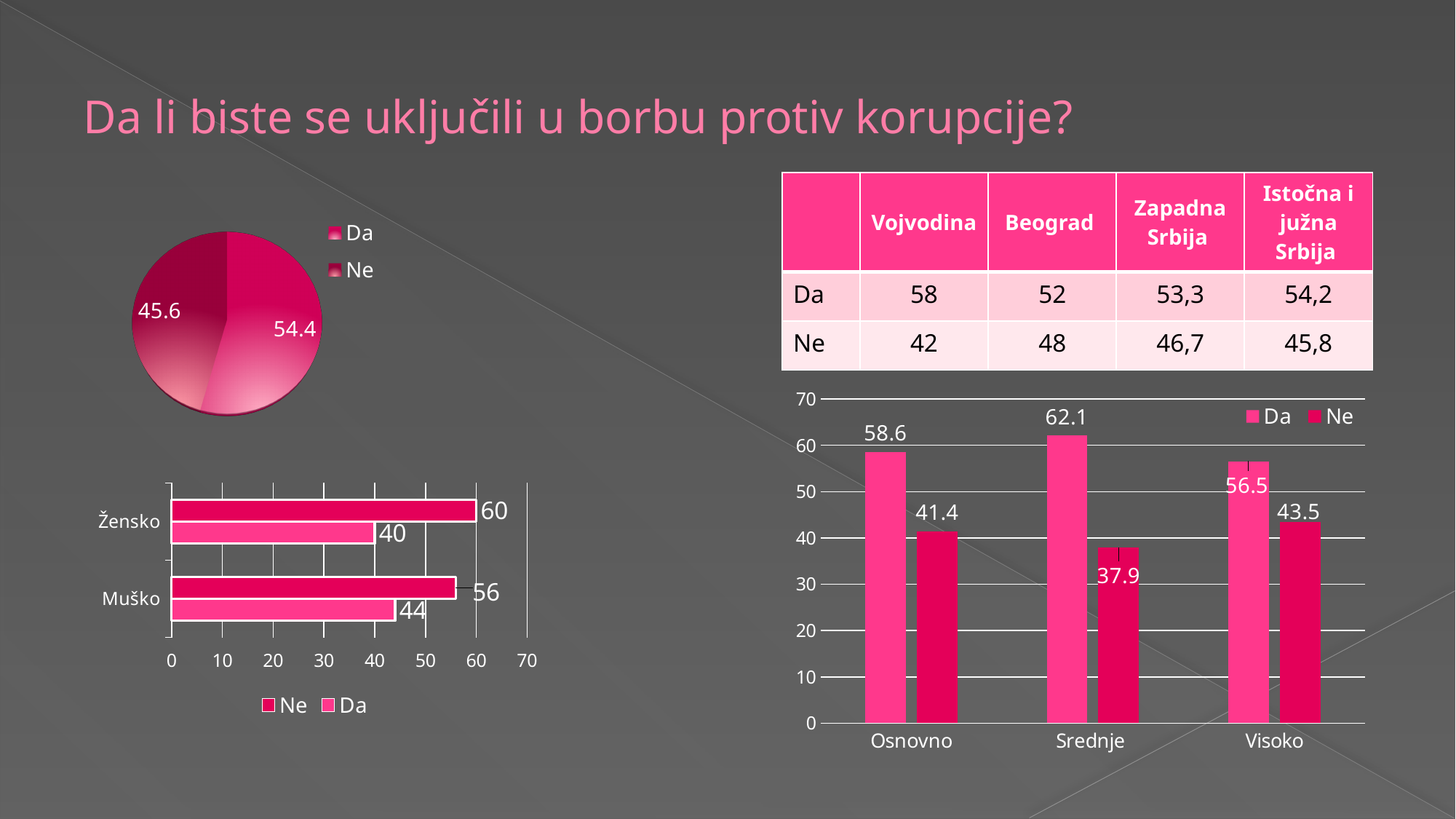
In the horizontal bar chart at the bottom left, how many series does the legend list? 2 In the pie chart at the top left, what is the value of the Ne slice? 45.6 In the bar chart at the bottom right, what is the Ne value for Visoko? 43.5 In the pie chart at the top left, which slice is larger, Da or Ne? Da In the bar chart at the bottom right, what is the Da value for Srednje? 62.1 In the pie chart at the top left, what is the value of the Da slice? 54.4 In the bar chart at the bottom right, which category has the highest Da value? Srednje In the horizontal bar chart at the bottom left, what is the Da value for Muško? 44 In the bar chart at the bottom right, how many categories are shown on the x axis? 3 In the bar chart at the bottom right, which category has the lowest Ne value? Srednje In the horizontal bar chart at the bottom left, what is the Ne value for Žensko? 60 In the horizontal bar chart at the bottom left, what is the difference between the Ne and Da values for Muško? 12